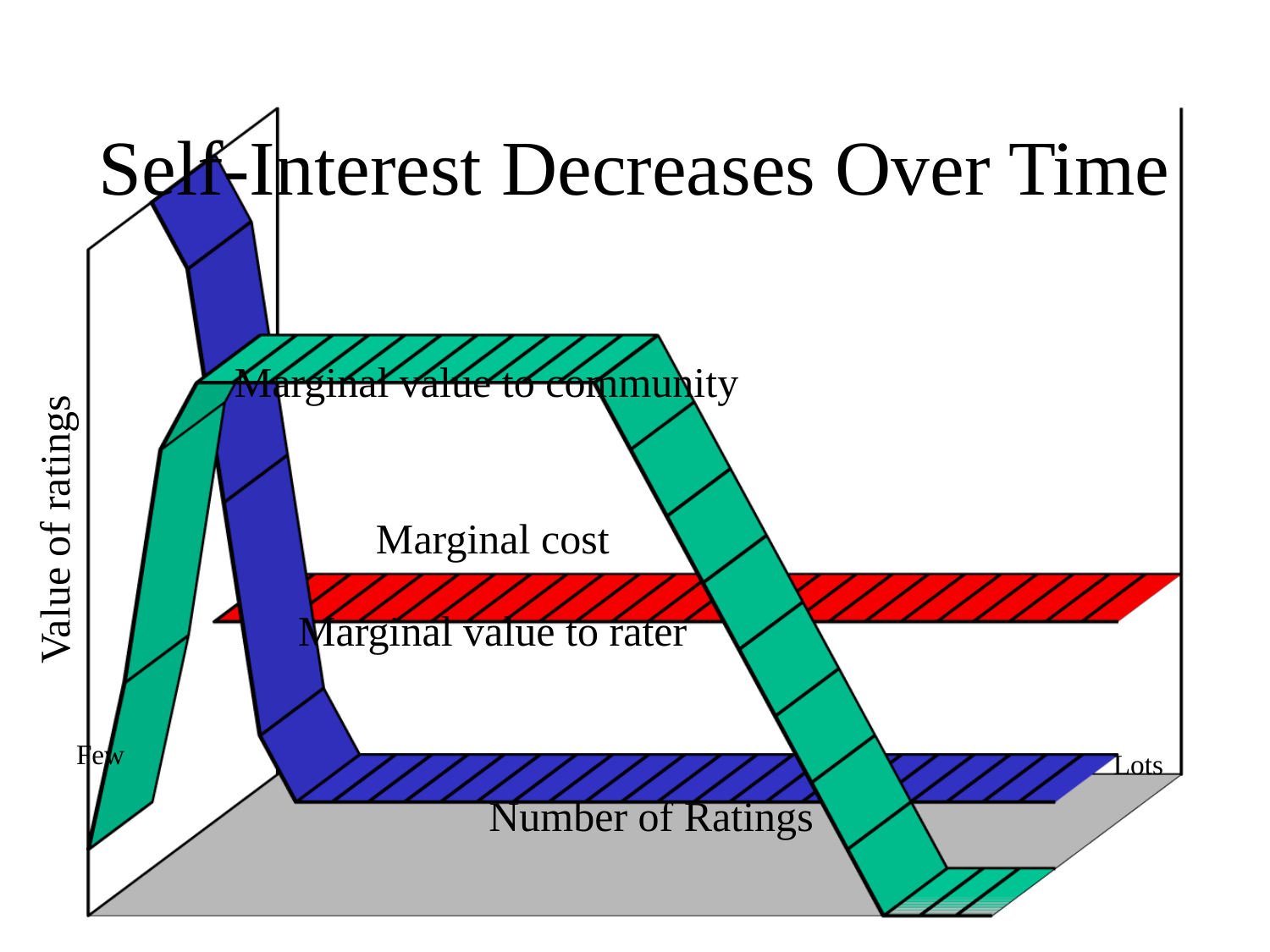
How does the Marginal value to rater series change as the number of ratings goes from Few to Lots? falls, then stays flat Does the Marginal cost series rise, fall, or stay flat as the number of ratings increases? stays flat At Lots ratings, which is higher: Marginal cost or Marginal value to rater? Marginal cost Which series is the lowest at Lots ratings? Marginal value to community How does the Marginal value to community series change as the number of ratings goes from Few to Lots? rises, plateaus, then falls What is the label of the horizontal axis? Number of Ratings At Lots ratings, which is higher: Marginal cost or Marginal value to community? Marginal cost Which series reaches the highest value on the chart? Marginal value to rater What is the title of the chart? Self-Interest Decreases Over Time At Few ratings, which is higher: Marginal value to rater or Marginal value to community? Marginal value to rater What kind of chart is shown on the slide? line chart How many series are plotted on the chart? 3